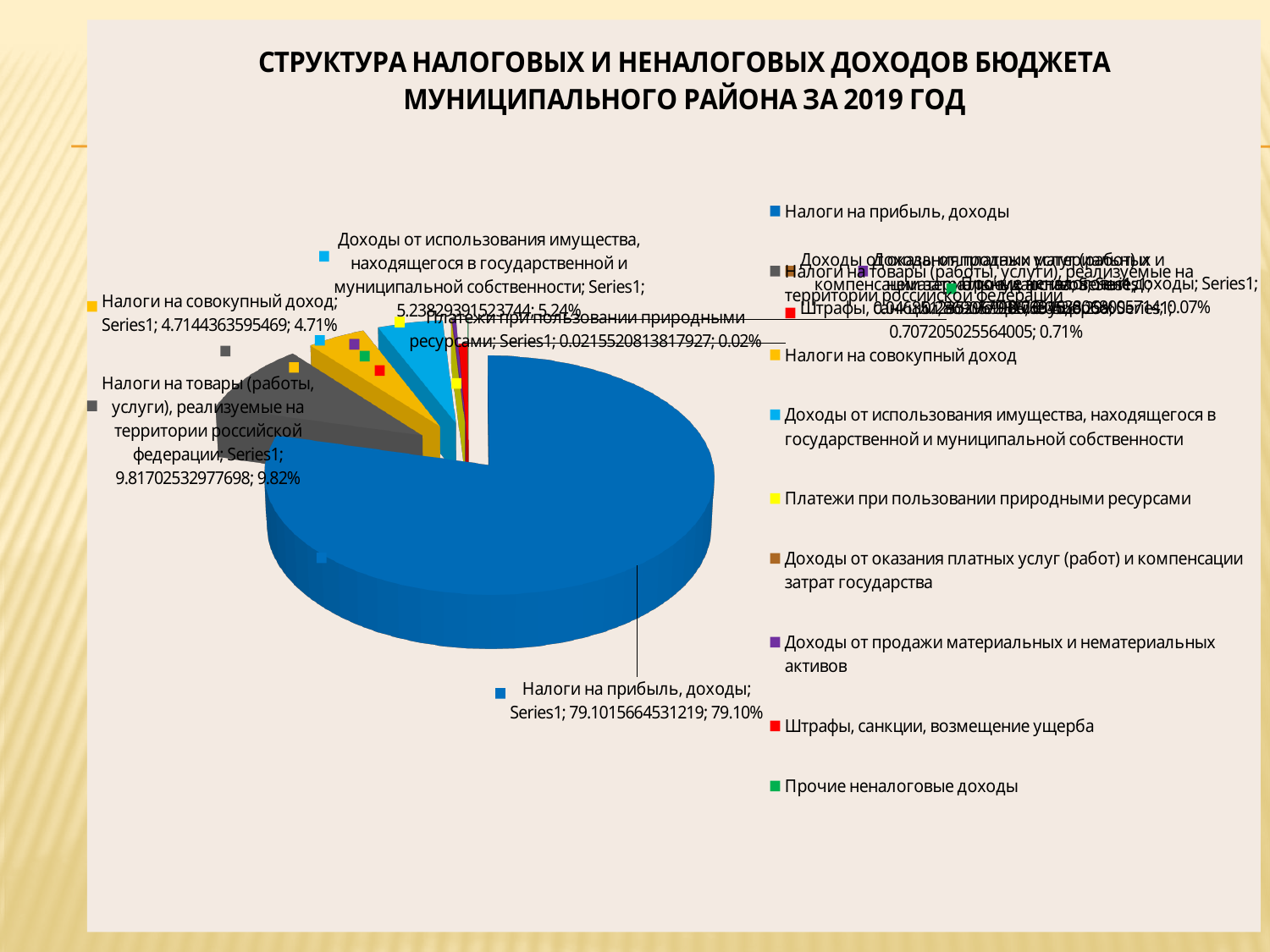
What share of the pie does "Платежи при пользовании природными ресурсами" have? 0.02% Which is larger: the share for "Налоги на совокупный доход" or the share for "Доходы от использования имущества, находящегося в государственной и муниципальной собственности"? Доходы от использования имущества, находящегося в государственной и муниципальной собственности What colour is the slice for "Налоги на прибыль, доходы"? blue What is the title of the chart? СТРУКТУРА НАЛОГОВЫХ И НЕНАЛОГОВЫХ ДОХОДОВ БЮДЖЕТА МУНИЦИПАЛЬНОГО РАЙОНА ЗА 2019 ГОД What share of the pie does "Налоги на совокупный доход" have? 4.71% What share of the pie does "Доходы от использования имущества, находящегося в государственной и муниципальной собственности" have? 5.24% What share of the pie does "Налоги на прибыль, доходы" have? 79.10% What is the difference in percentage points between the share for "Налоги на прибыль, доходы" and the share for "Налоги на товары (работы, услуги), реализуемые на территории российской федерации"? 69.28% Which category has the largest slice of the pie? Налоги на прибыль, доходы What kind of chart is shown on the slide? pie chart What share of the pie does "Налоги на товары (работы, услуги), реализуемые на территории российской федерации" have? 9.82% How many entries does the legend list? 9